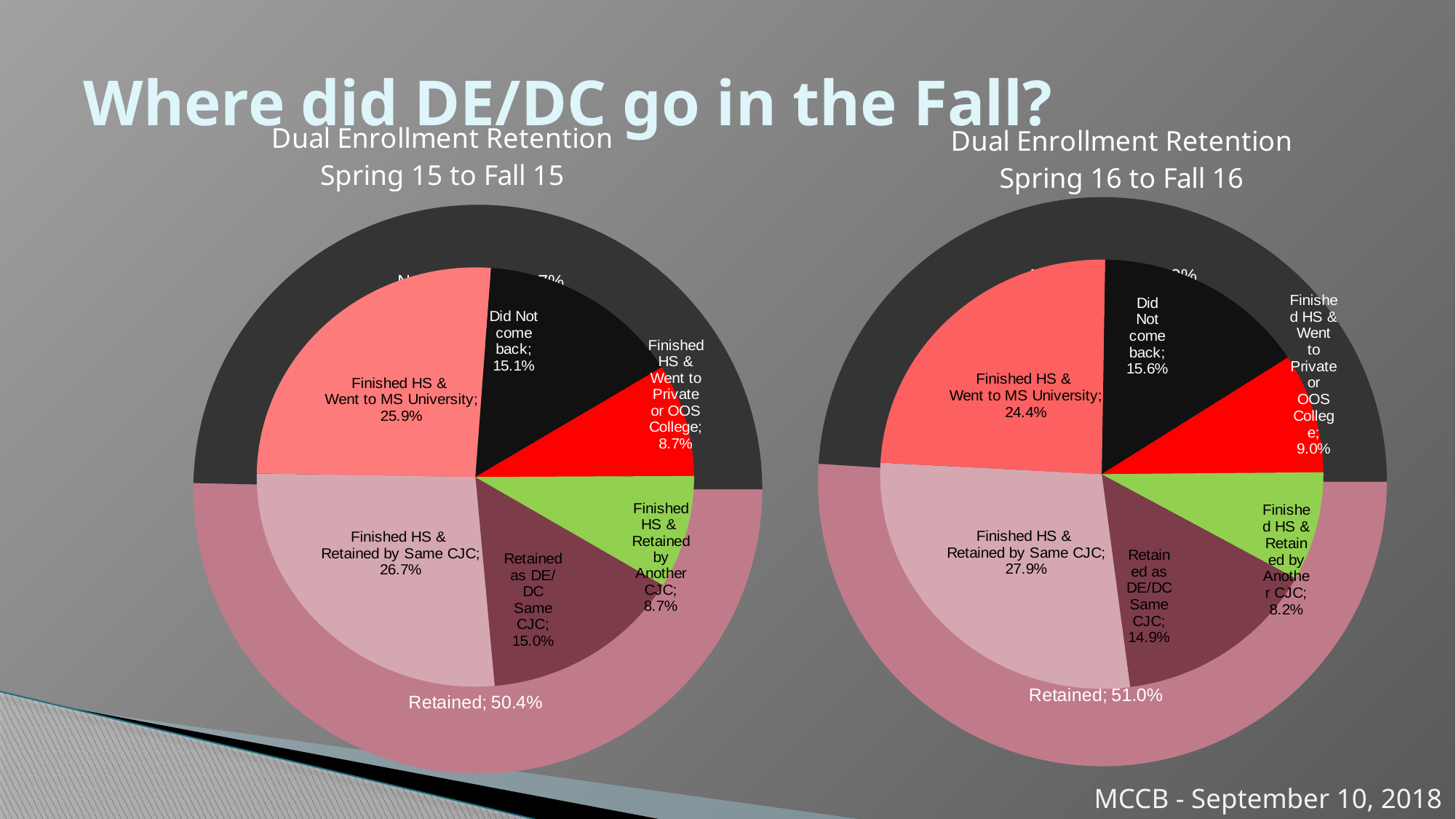
In the Spring 15 to Fall 15 chart, which category has the largest share? Finished HS & Retained by Same CJC In the Spring 16 to Fall 16 chart, which category has the largest share? Finished HS & Retained by Same CJC What is the difference between the Finished HS & Went to MS University shares in the Spring 15 to Fall 15 chart and the Spring 16 to Fall 16 chart? 1.5% What kind of chart is used for Dual Enrollment Retention Spring 16 to Fall 16? Pie chart In the Spring 16 to Fall 16 chart, which category has the smallest share? Finished HS & Retained by Another CJC In the Spring 15 to Fall 15 chart, what percentage finished HS and went to a private or OOS college? 8.7% In the Spring 16 to Fall 16 chart, what is the overall Retained share shown on the outer ring? 51.0% In the Spring 15 to Fall 15 chart, what is the overall Retained share shown on the outer ring? 50.4% How many categories are shown in the inner pie of the Spring 15 to Fall 15 chart? 6 In the Spring 16 to Fall 16 chart, what percentage finished HS and were retained by the same CJC? 27.9% In the Spring 15 to Fall 15 chart, what percentage of students did not come back? 15.1% Which is larger in the Spring 16 to Fall 16 chart: Did Not come back or Retained as DE/DC Same CJC? Did Not come back